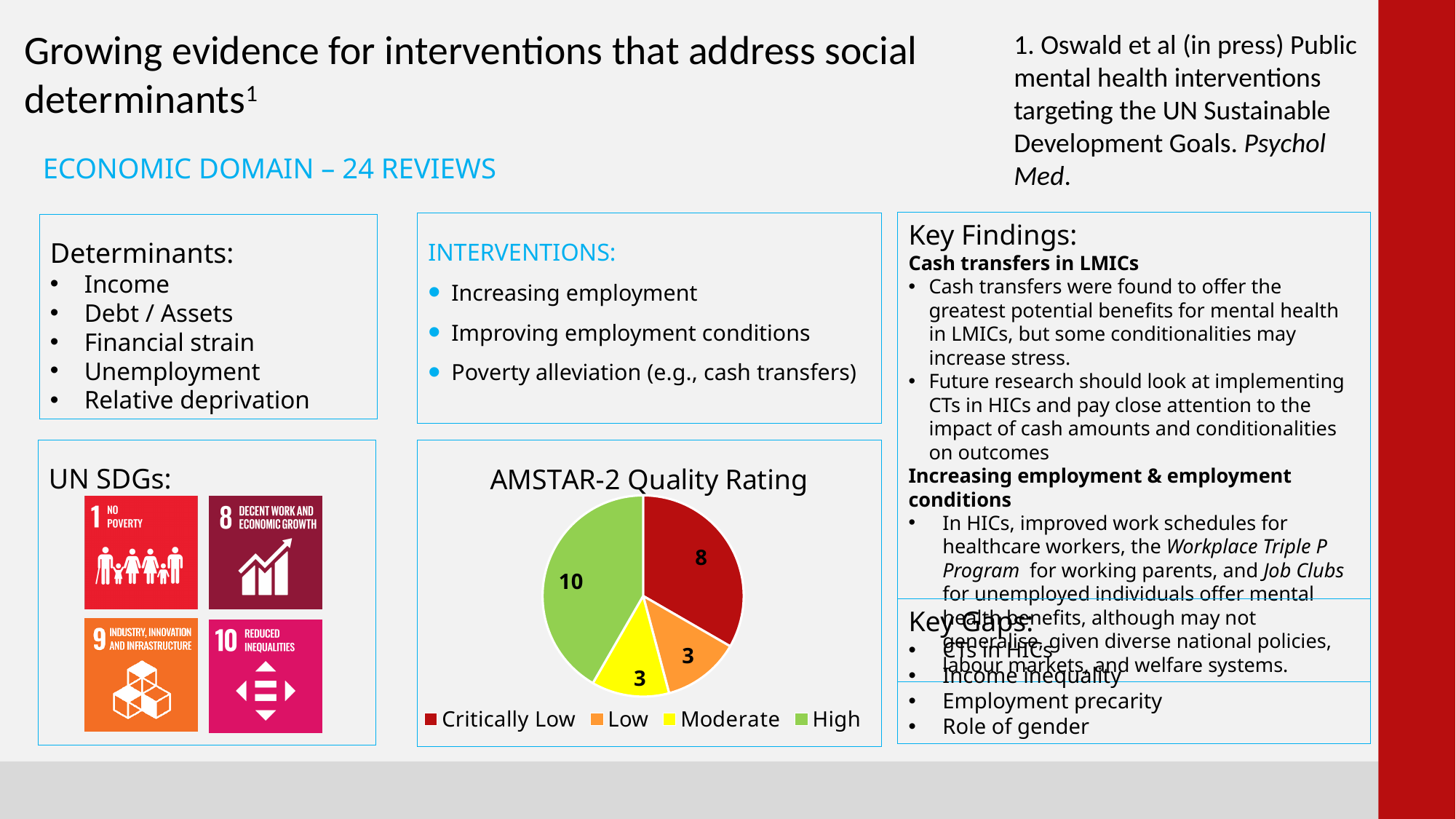
How many categories does the AMSTAR-2 Quality Rating pie chart have? 4 In the AMSTAR-2 Quality Rating chart, which is larger: Critically Low or Low? Critically Low What colour represents the Moderate category in the AMSTAR-2 Quality Rating chart? Yellow Which quality rating category has the largest slice in the AMSTAR-2 Quality Rating chart? High How many reviews are rated High in the AMSTAR-2 Quality Rating chart? 10 What is the difference between the number of High and Critically Low rated reviews in the AMSTAR-2 Quality Rating chart? 2 How many reviews are rated Critically Low in the AMSTAR-2 Quality Rating chart? 8 What type of chart is used to show the AMSTAR-2 Quality Rating? Pie chart What is the title of the pie chart on the slide? AMSTAR-2 Quality Rating What is the total number of reviews represented in the AMSTAR-2 Quality Rating pie chart? 24 How many reviews are rated Moderate in the AMSTAR-2 Quality Rating chart? 3 What share of the AMSTAR-2 Quality Rating pie does the Low category represent? 12.5%